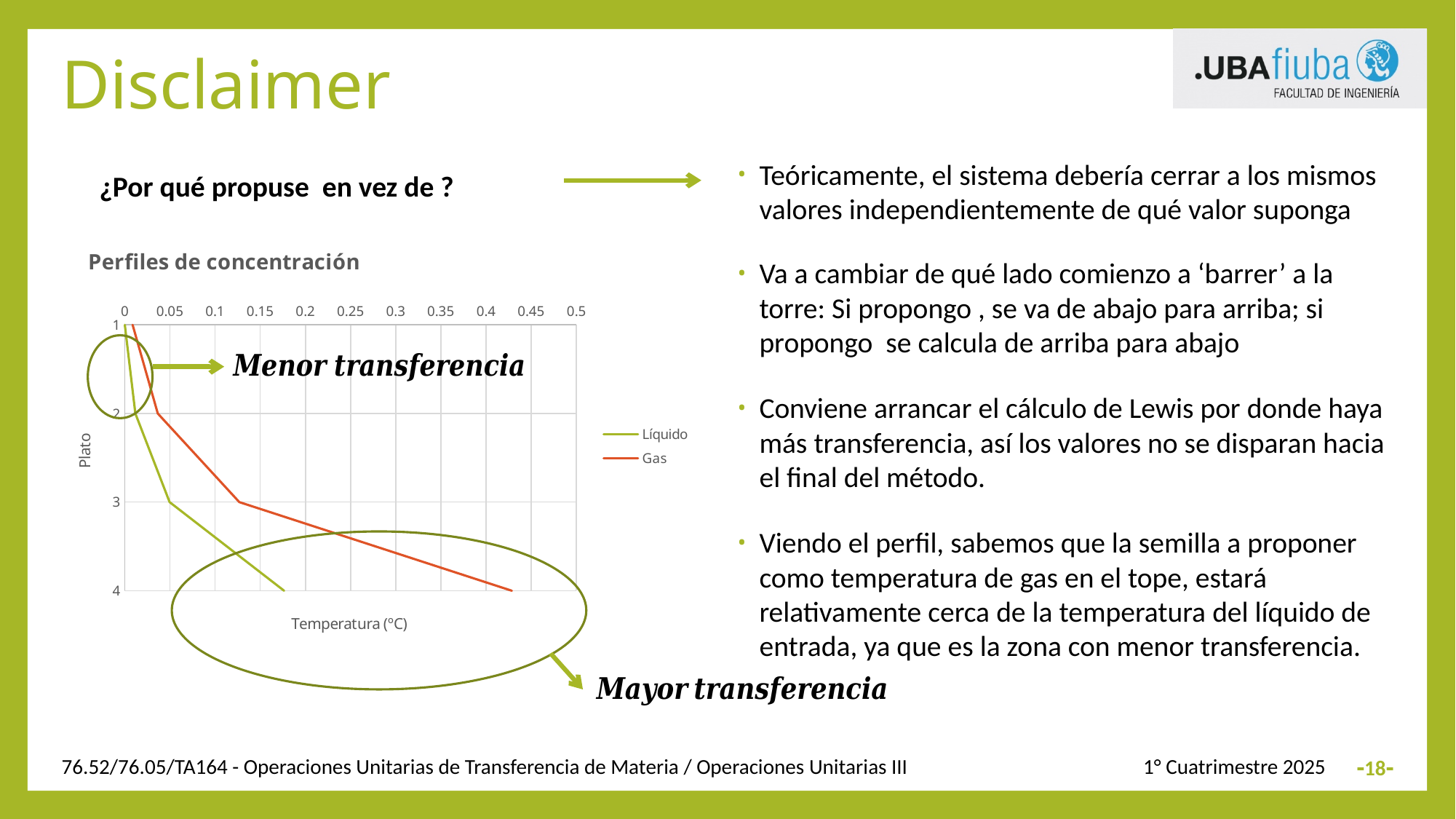
Is the Líquido value at Plato 3 greater or less than 0.1? less What are the two series named in the chart legend? Líquido and Gas Is the Gas value at Plato 4 greater or less than 0.3? greater How many plates (Plato) are plotted on the vertical axis of the chart? 4 How many series does the chart legend list? 2 Is the Gas value at Plato 3 greater or less than 0.1? greater What is the title of the chart? Perfiles de concentración At which Plato does the Gas series reach its highest value? 4 At Plato 4, which series has the larger value, Líquido or Gas? Gas What kind of chart is shown on the slide? line chart Do the Gas values increase or decrease as the Plato number goes from 1 to 4? increase